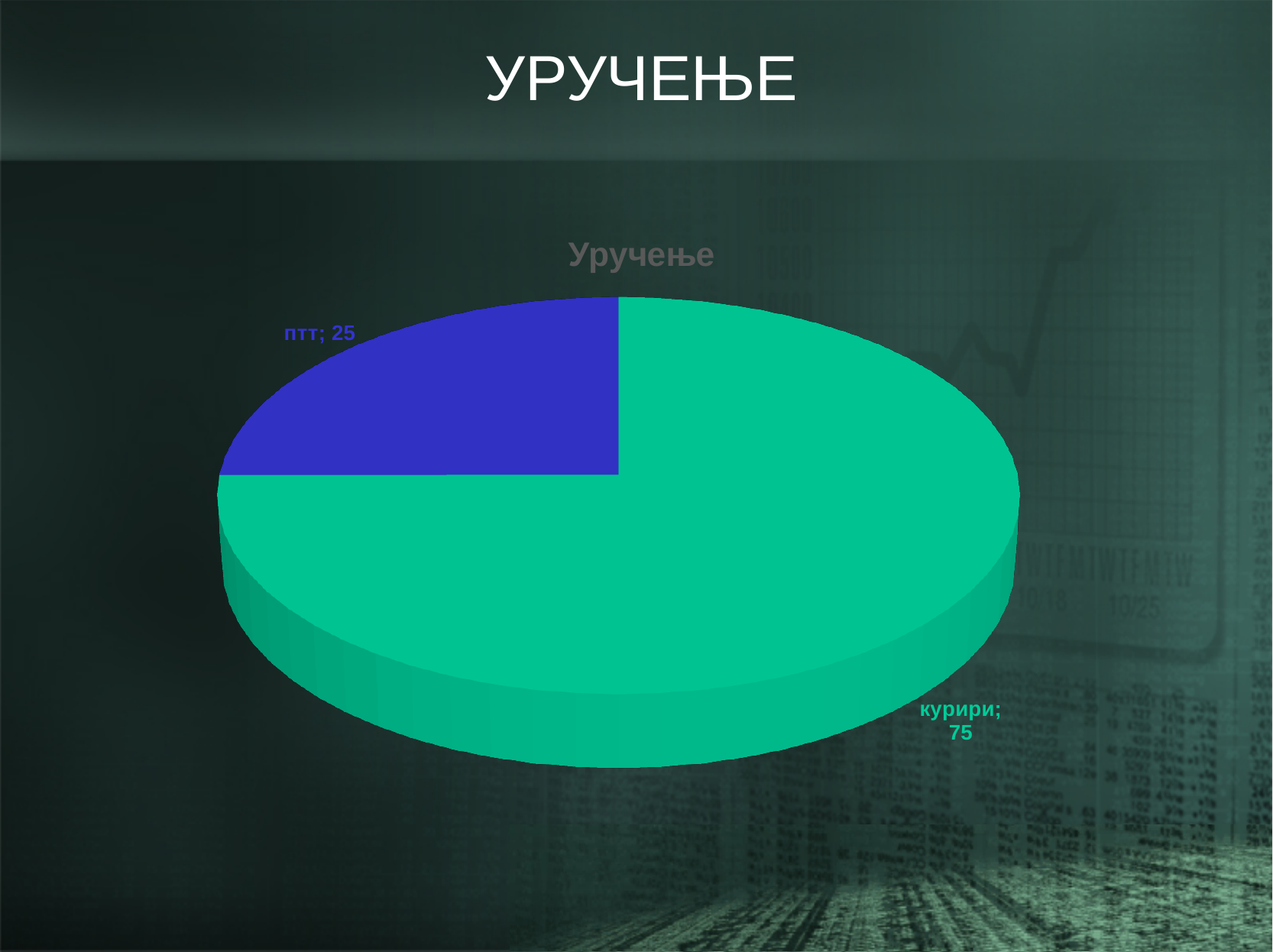
What is the value for курири? 75 What share of the pie does the курири slice represent? 75% What type of chart is shown on the slide? pie chart What is the difference between the values for курири and птт? 50 What is the title of the chart? Уручење What share of the pie does the птт slice represent? 25% What colour is the курири slice? green How many slices does the pie chart have? 2 Which category has the largest slice? курири What is the value for птт? 25 Which category has the smallest slice? птт Which is larger, the value for птт or the value for курири? курири